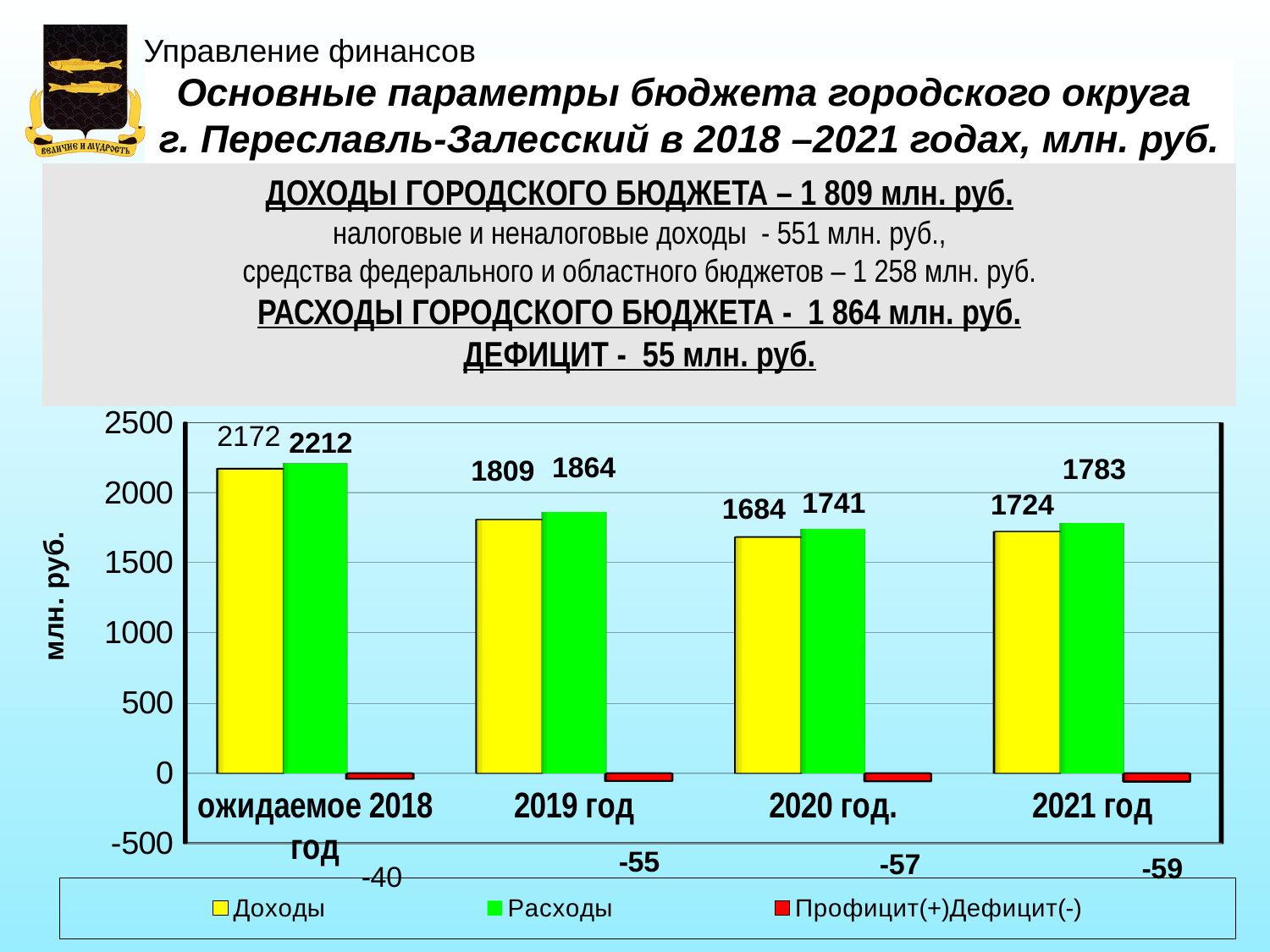
How many series does the legend list? 3 Which category has the highest value for Расходы? ожидаемое 2018 год What kind of chart is shown on the slide? bar chart What is the value of Доходы for 2020 год.? 1684 What is the difference between Расходы and Доходы for 2021 год? 59 Which category has the lowest value for Доходы? 2020 год. What is the value of Профицит(+)Дефицит(-) for 2021 год? -59 What is the value of Доходы for 2019 год? 1809 What is the value of Расходы for ожидаемое 2018 год? 2212 How many categories are shown on the x axis? 4 What is the label of the y axis? млн. руб. Which is larger for 2019 год: Доходы or Расходы? Расходы